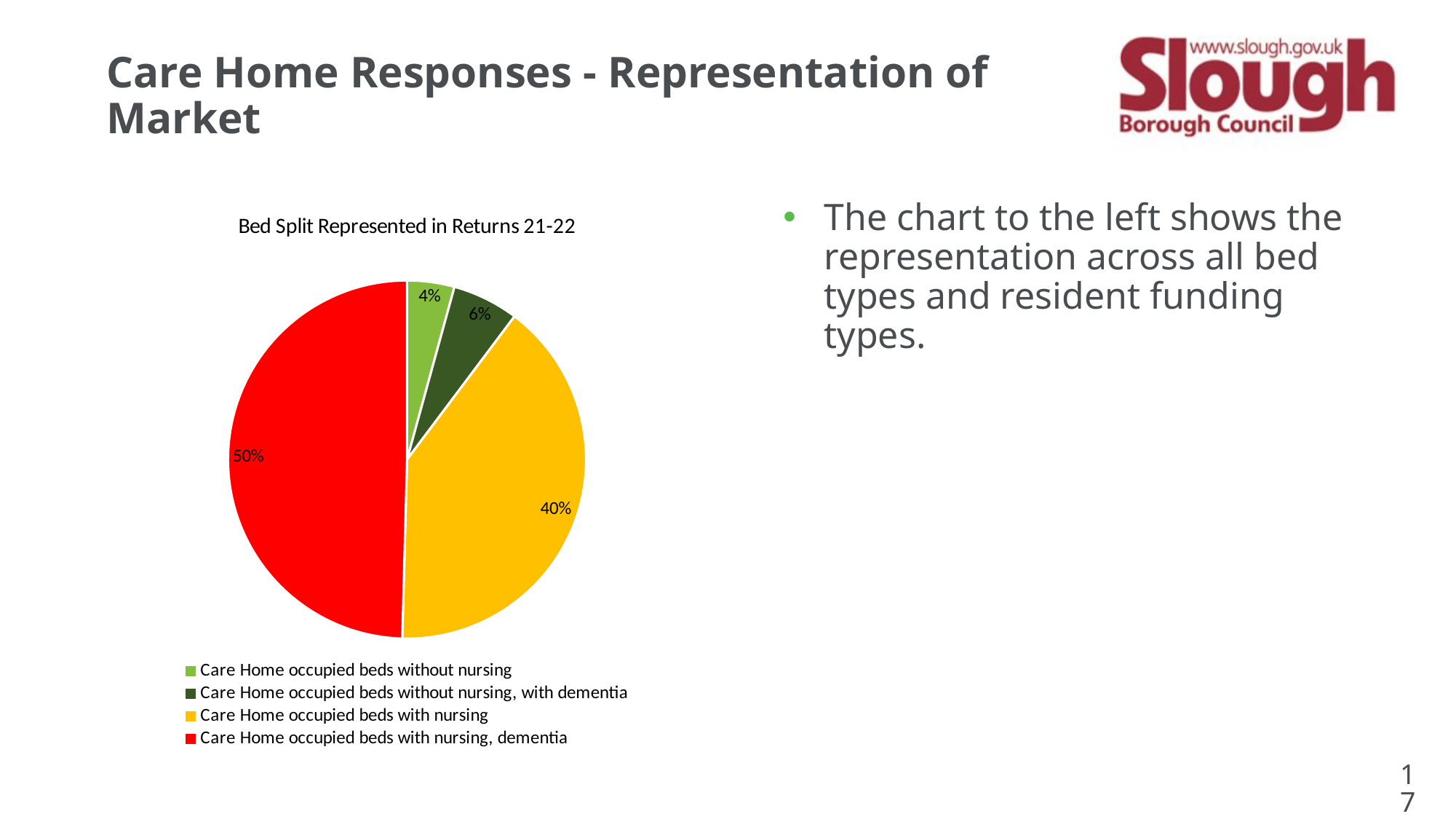
Which category has the largest slice of the pie? Care Home occupied beds with nursing, dementia How many categories does the legend list? 4 What share of the pie is Care Home occupied beds without nursing, with dementia? 6% What kind of chart is shown on the slide? pie chart Which category has the smallest slice of the pie? Care Home occupied beds without nursing What is the title of the chart? Bed Split Represented in Returns 21-22 What share of the pie is Care Home occupied beds with nursing, dementia? 50% What share of the pie is Care Home occupied beds with nursing? 40% What colour is the slice for Care Home occupied beds with nursing? yellow What share of the pie is Care Home occupied beds without nursing? 4% Which is larger: the slice for Care Home occupied beds without nursing, with dementia or the slice for Care Home occupied beds without nursing? Care Home occupied beds without nursing, with dementia What is the difference in percentage points between Care Home occupied beds with nursing, dementia and Care Home occupied beds with nursing? 10 percentage points